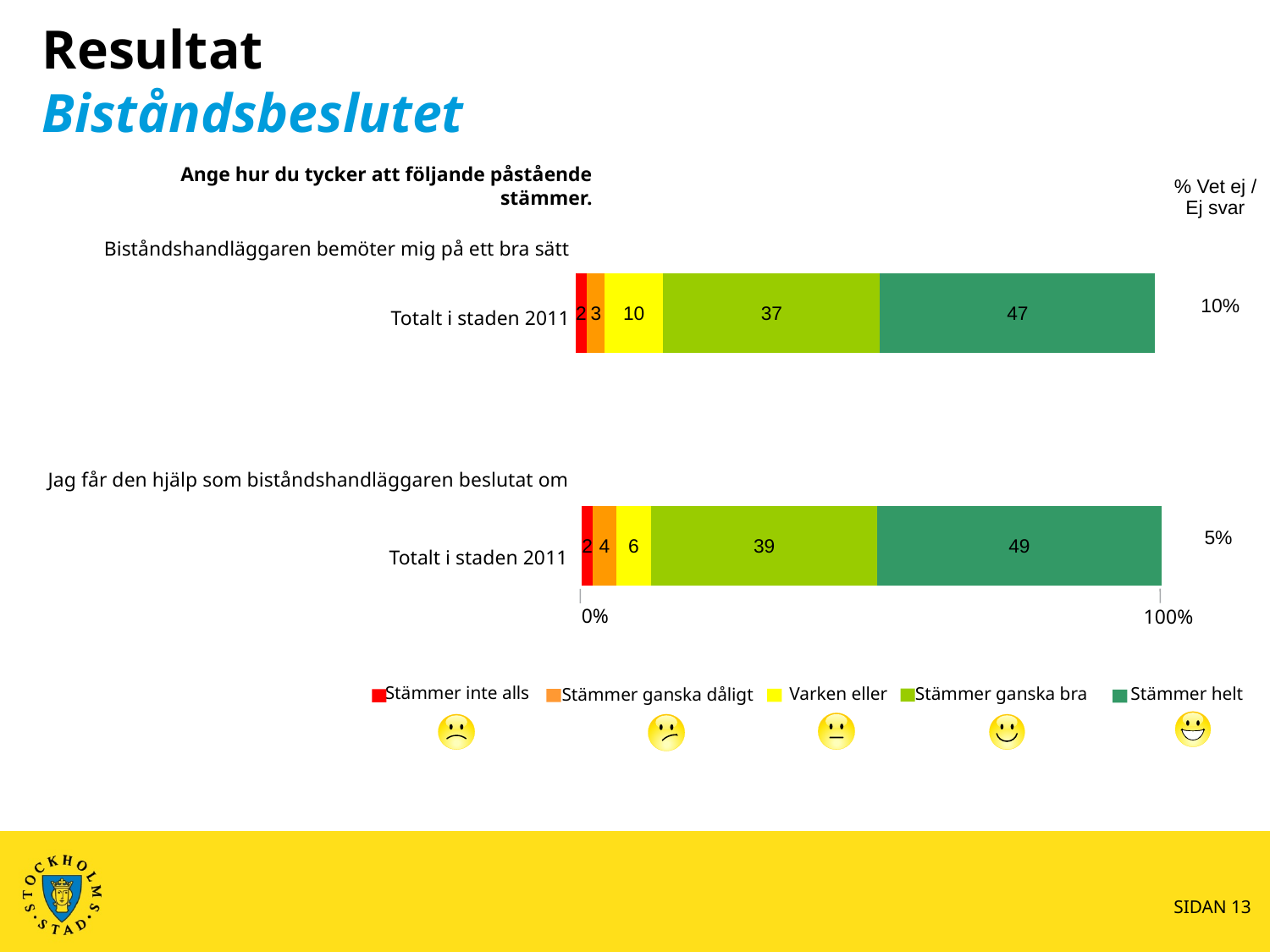
In the chart 'Jag får den hjälp som biståndshandläggaren beslutat om', what is the value for 'Stämmer ganska bra'? 39 Which is larger: 'Stämmer helt' in the chart 'Jag får den hjälp som biståndshandläggaren beslutat om' or 'Stämmer helt' in the chart 'Biståndshandläggaren bemöter mig på ett bra sätt'? Jag får den hjälp som biståndshandläggaren beslutat om How many series does the legend list for the charts on this slide? 5 In the chart 'Jag får den hjälp som biståndshandläggaren beslutat om', which response category has the highest value? Stämmer helt In the chart 'Biståndshandläggaren bemöter mig på ett bra sätt', what is the '% Vet ej / Ej svar' value shown to the right of the bar? 10% What kind of chart is used for 'Jag får den hjälp som biståndshandläggaren beslutat om'? Stacked bar chart In the chart 'Biståndshandläggaren bemöter mig på ett bra sätt', what is the value for 'Varken eller'? 10 In the chart 'Biståndshandläggaren bemöter mig på ett bra sätt', which response category has the lowest value? Stämmer inte alls In the chart 'Jag får den hjälp som biståndshandläggaren beslutat om', what is the value for 'Stämmer ganska dåligt'? 4 In the legend, which response category is shown in red? Stämmer inte alls In the chart 'Biståndshandläggaren bemöter mig på ett bra sätt', what is the difference between 'Stämmer helt' and 'Stämmer ganska bra'? 10 In the chart 'Biståndshandläggaren bemöter mig på ett bra sätt', what is the value for 'Stämmer helt' for Totalt i staden 2011? 47